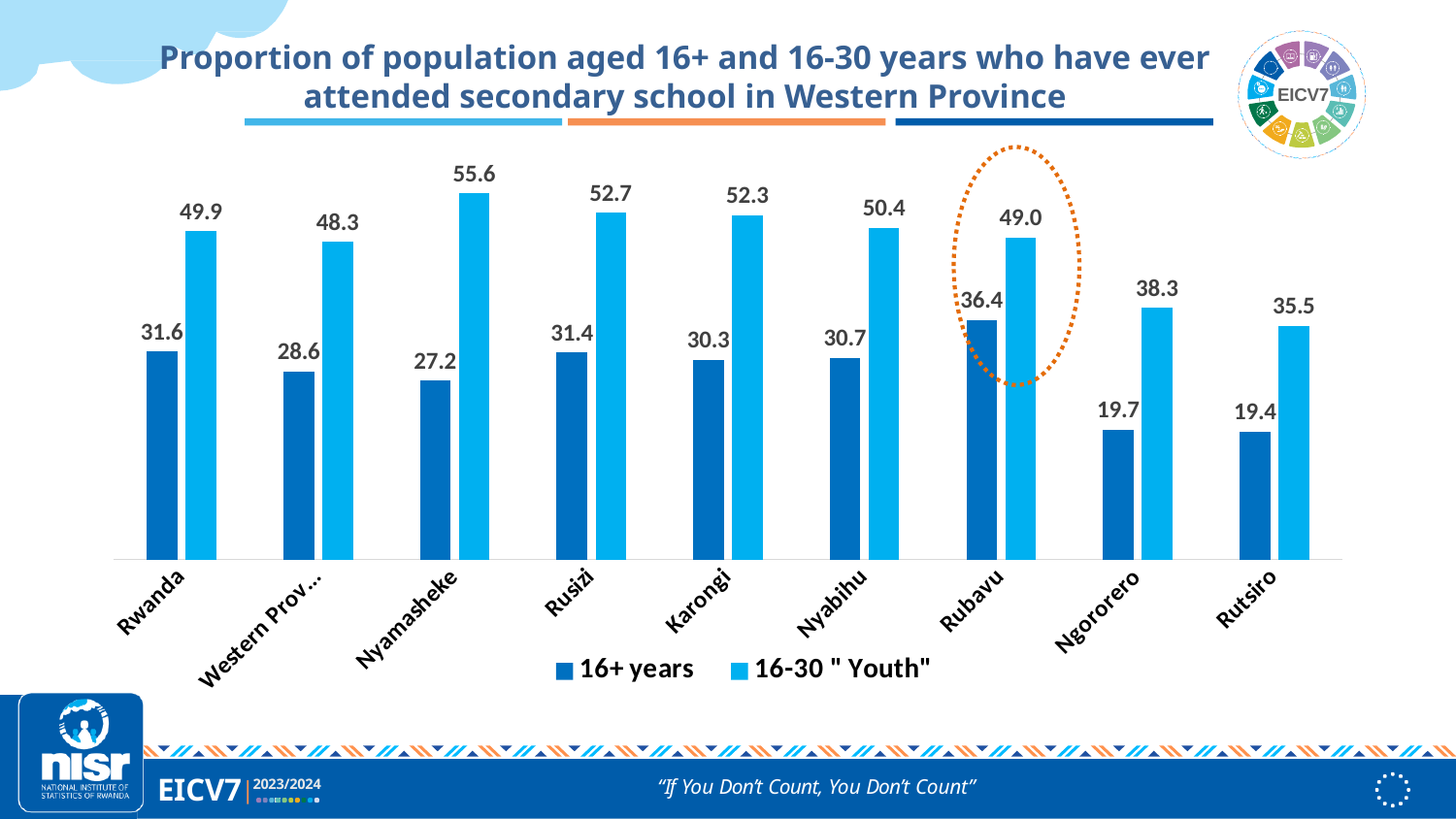
What kind of chart is shown on the slide? Bar chart How many categories are shown on the x axis? 9 What is the difference between the 16-30 "Youth" value and the 16+ years value for Rubavu? 12.6 Which category has the highest value in the 16+ years series? Rubavu What is the value for Rwanda in the 16+ years series? 31.6 Which is larger for Rusizi: the 16+ years value or the 16-30 "Youth" value? 16-30 "Youth" How many series does the legend list? 2 What is the value for Ngororero in the 16+ years series? 19.7 What is the value for Nyamasheke in the 16-30 "Youth" series? 55.6 Which category has the highest value in the 16-30 "Youth" series? Nyamasheke Which category is highlighted with a dashed orange circle? Rubavu Which category has the lowest value in the 16+ years series? Rutsiro